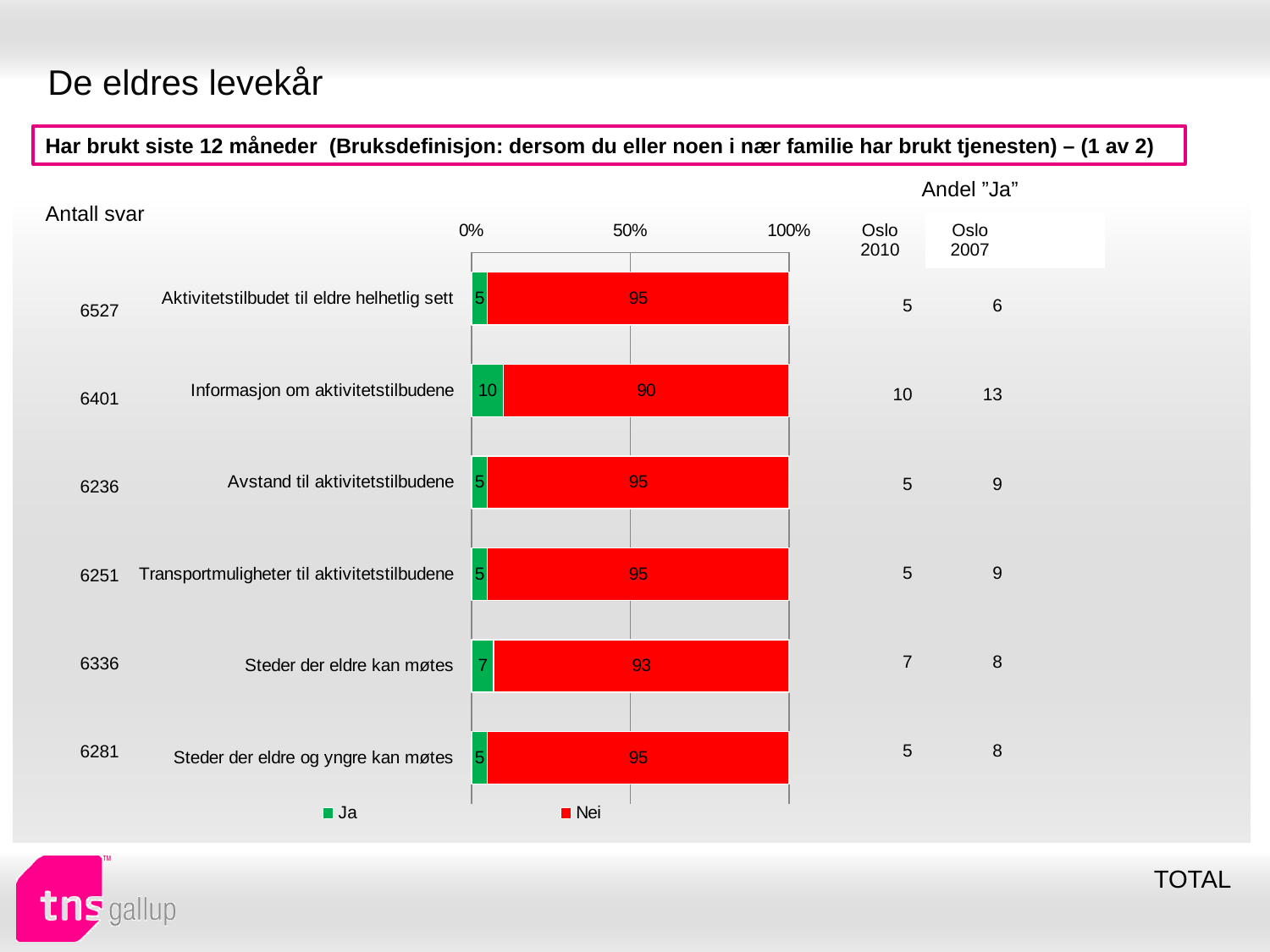
What is the total of the stacked bar for "Steder der eldre kan møtes"? 100 What is the "Nei" value for "Informasjon om aktivitetstilbudene"? 90 What is the difference between the "Nei" values for "Aktivitetstilbudet til eldre helhetlig sett" and "Informasjon om aktivitetstilbudene"? 5 How many categories are plotted in the chart? 6 Which category has the lowest "Nei" value? Informasjon om aktivitetstilbudene Which category has the highest "Ja" value? Informasjon om aktivitetstilbudene What is the "Nei" value for "Aktivitetstilbudet til eldre helhetlig sett"? 95 Which is larger: the "Ja" value for "Steder der eldre kan møtes" or the "Ja" value for "Avstand til aktivitetstilbudene"? Steder der eldre kan møtes What is the "Ja" value for "Steder der eldre kan møtes"? 7 What are the two legend entries of the chart? Ja and Nei What kind of chart is shown on the slide? stacked bar chart How many series does the chart legend list? 2